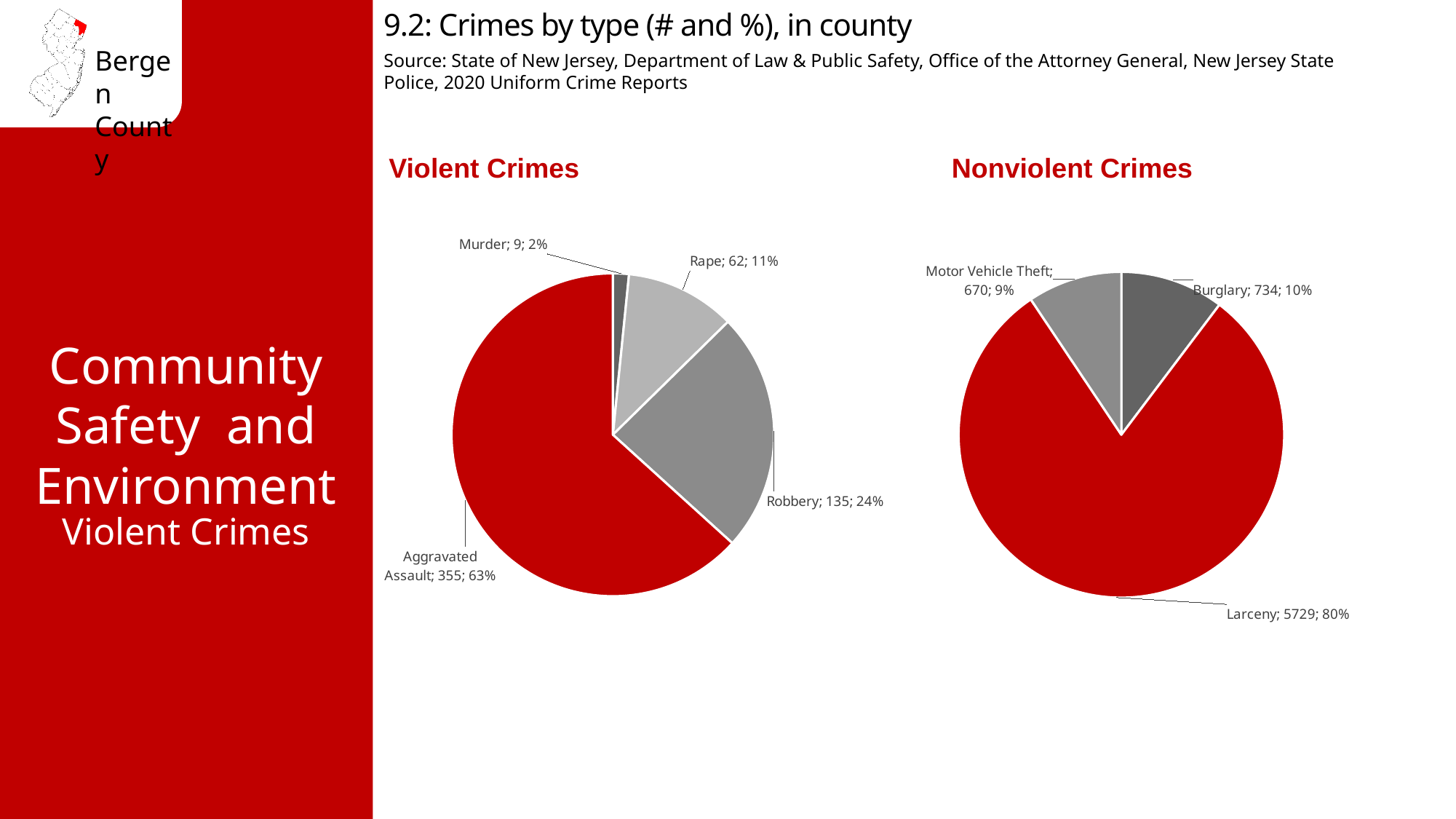
What kind of chart is the Nonviolent Crimes chart? Pie chart What is the title of the slide's chart section? 9.2: Crimes by type (# and %), in county In the Nonviolent Crimes chart, what percentage of nonviolent crimes is motor vehicle theft? 9% In the Violent Crimes chart, which category has the largest slice? Aggravated Assault In the Violent Crimes chart, how many categories are shown? 4 In the Violent Crimes chart, which category has the smallest slice? Murder In the Violent Crimes chart, what percentage of violent crimes is robbery? 24% In the Violent Crimes chart, what is the difference between the number of robberies and the number of rapes? 73 In the Nonviolent Crimes chart, what is the difference between the number of burglaries and the number of motor vehicle thefts? 64 In the Nonviolent Crimes chart, how many larcenies are shown? 5729 In the Violent Crimes chart, how many aggravated assaults are shown? 355 In the Nonviolent Crimes chart, which is larger, burglary or motor vehicle theft? Burglary